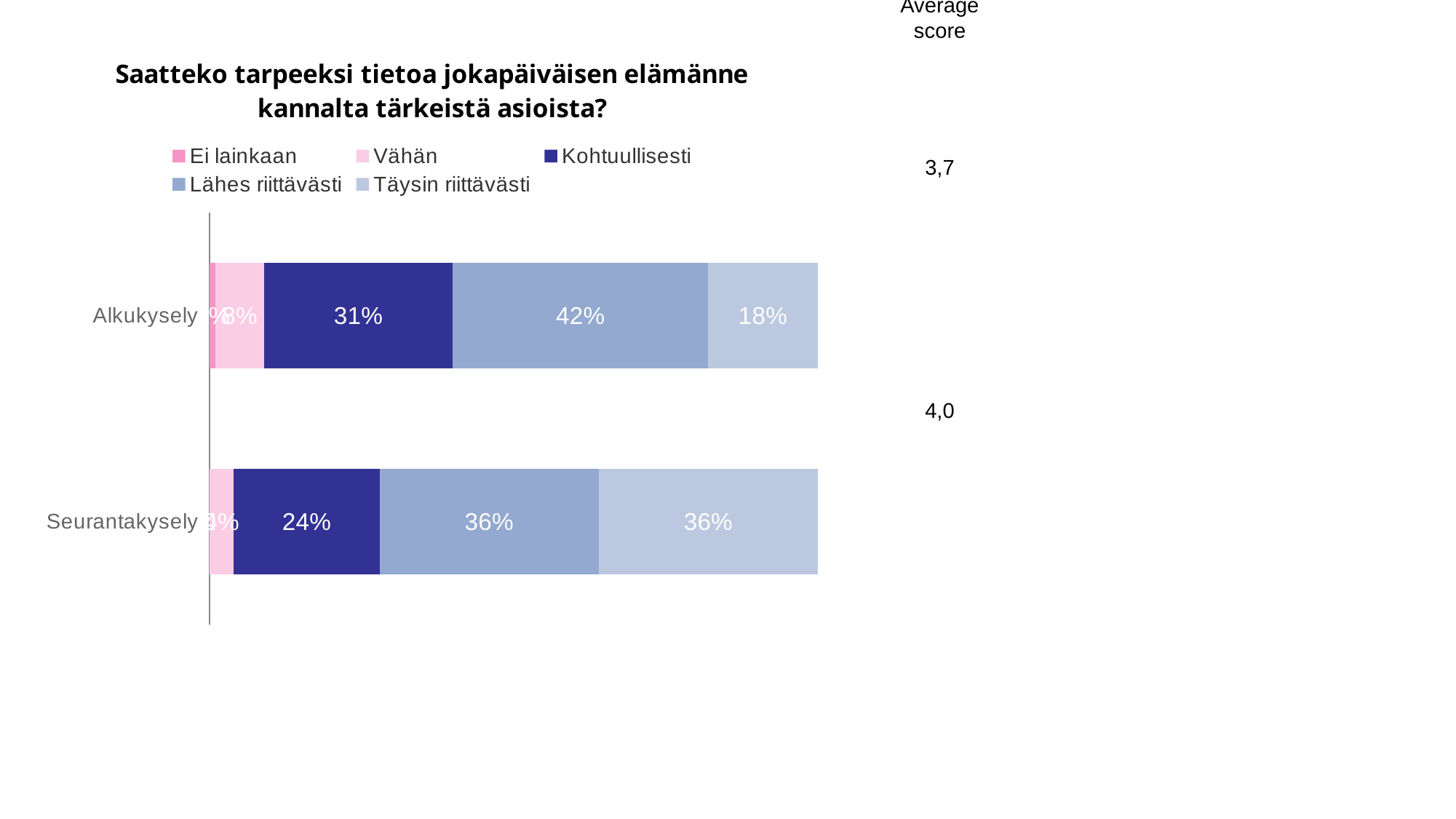
Which survey has the larger Kohtuullisesti share, Alkukysely or Seurantakysely? Alkukysely What percentage of Alkukysely respondents answered Vähän? 8% What percentage of Alkukysely respondents answered Lähes riittävästi? 42% What percentage of Alkukysely respondents answered Kohtuullisesti? 31% By how many percentage points did the Täysin riittävästi share change from Alkukysely to Seurantakysely? 18 percentage points What percentage of Seurantakysely respondents answered Täysin riittävästi? 36% What percentage of Seurantakysely respondents answered Kohtuullisesti? 24% What percentage of Alkukysely respondents answered Täysin riittävästi? 18% What type of chart is shown on the slide? Stacked bar chart How many surveys (bars) are shown in the chart? 2 How many response categories does the legend list? 5 Which response category has the largest share in the Alkukysely bar? Lähes riittävästi